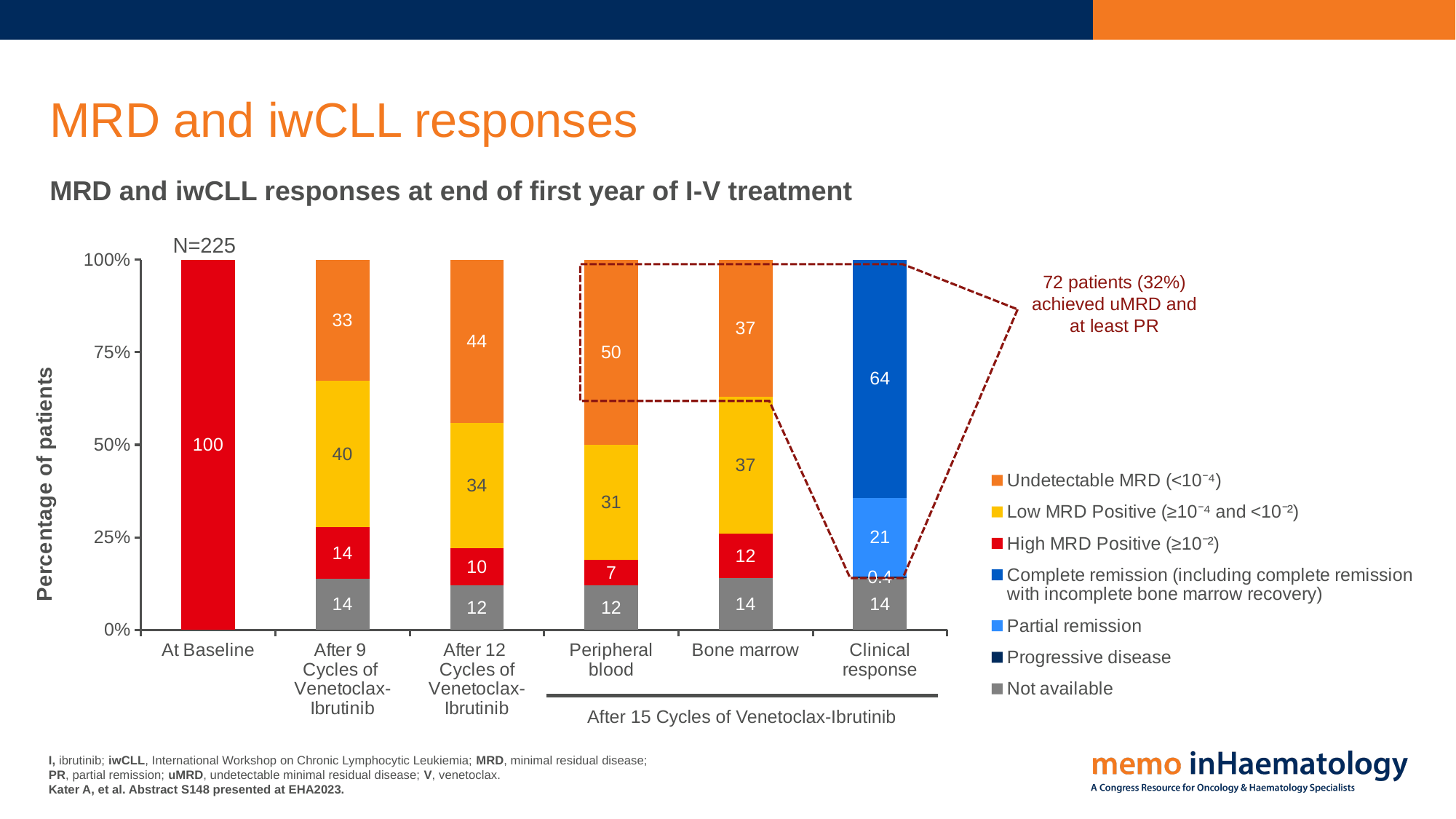
How many categories are shown on the x axis of the chart? 6 Which category has the lowest High MRD Positive value? Peripheral blood What is the Low MRD Positive value after 9 cycles of Venetoclax-Ibrutinib? 40 Which category has the highest Undetectable MRD value? Peripheral blood How many series does the legend list? 7 What is the total of the Bone marrow stacked bar? 100 What is the difference in Undetectable MRD between After 12 Cycles and After 9 Cycles of Venetoclax-Ibrutinib? 11 What percentage of patients had Undetectable MRD in Peripheral blood after 15 cycles of Venetoclax-Ibrutinib? 50 Which has a larger Low MRD Positive value: After 9 Cycles or After 12 Cycles of Venetoclax-Ibrutinib? After 9 Cycles What is the Complete remission value in the Clinical response bar? 64 What kind of chart is shown on the slide? Stacked bar chart What is the Progressive disease value in the Clinical response bar? 0.4